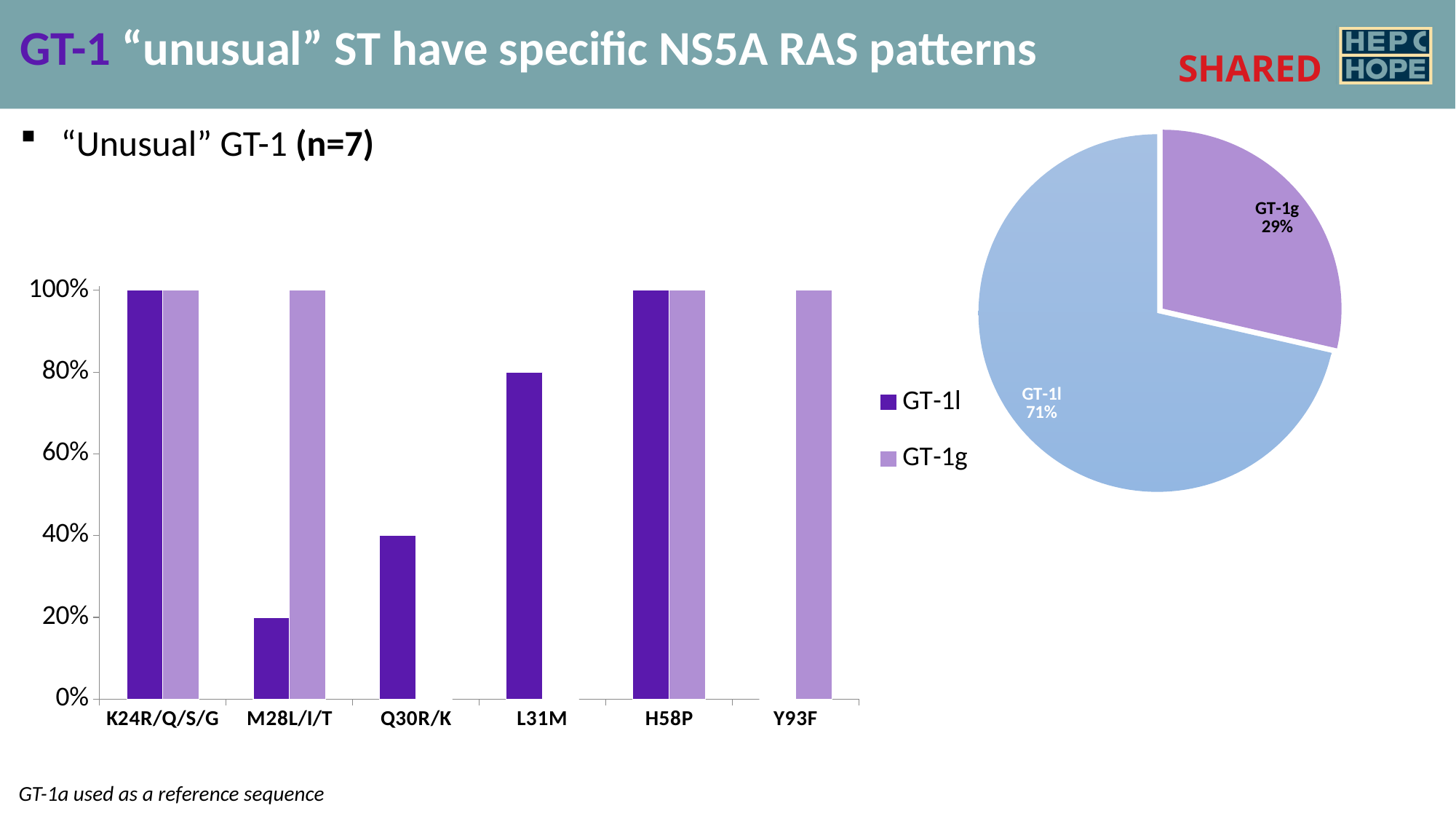
In the bar chart, what is the value for GT-1l at Q30R/K? 40% In the bar chart, what is the value for GT-1l at L31M? 80% How many categories are shown on the x axis of the bar chart? 6 In the pie chart, what share is labelled for GT-1g? 29% In the bar chart, which series has the larger value at M28L/I/T, GT-1l or GT-1g? GT-1g In the bar chart, what is the value for GT-1l at M28L/I/T? 20% In the bar chart, what is the value for GT-1g at Y93F? 100% In the bar chart, what is the difference between the GT-1g and GT-1l values at M28L/I/T? 80% What type of chart is shown on the left of the slide? Bar chart In the pie chart, what share is labelled for GT-1l? 71% How many series does the legend of the bar chart list? 2 In the pie chart, which slice is larger, GT-1l or GT-1g? GT-1l